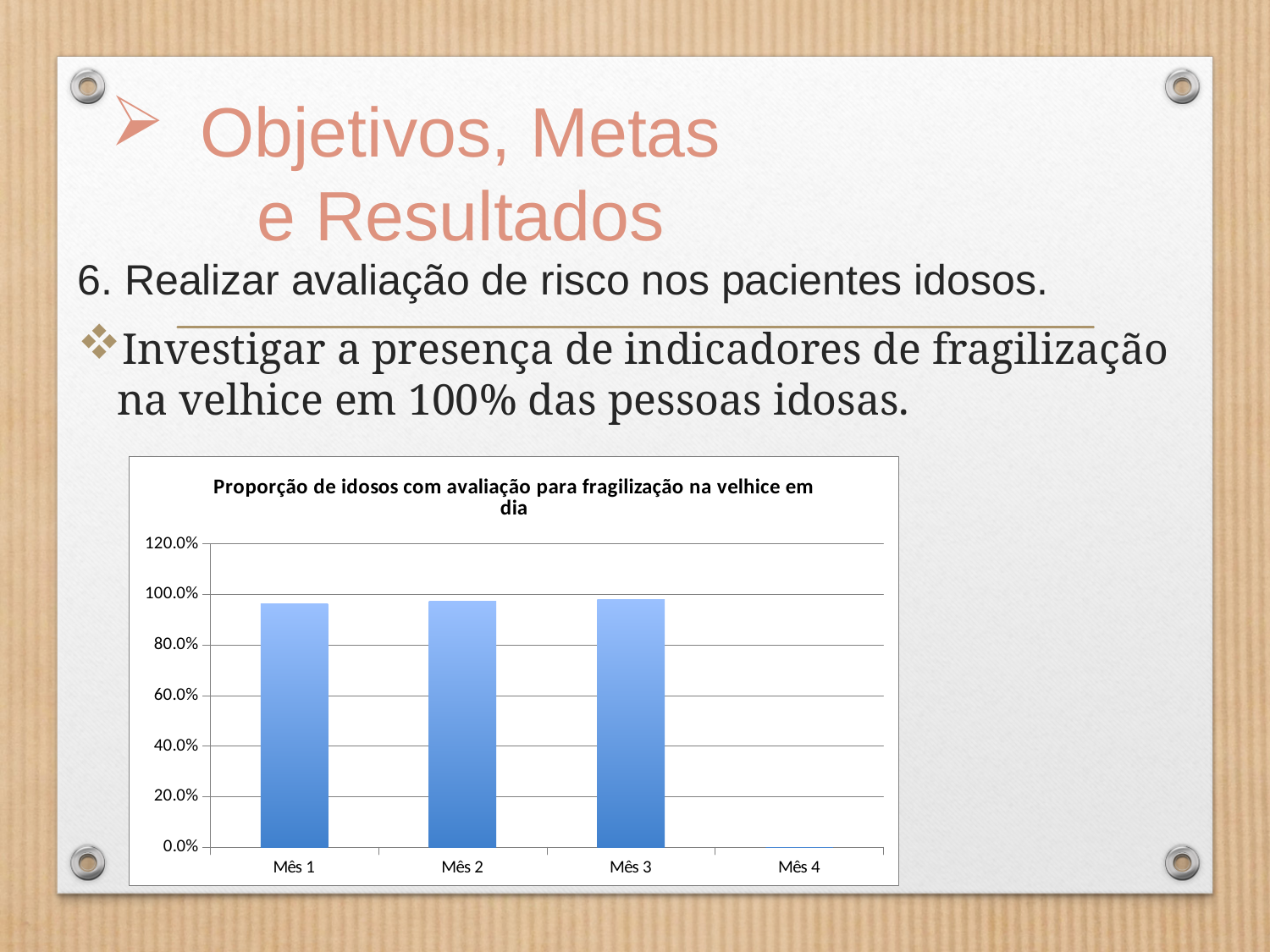
Is the value for Mês 1 greater or less than 80.0%? greater What is the highest value shown on the y axis of the chart? 120.0% Is the value for Mês 3 greater or less than 80.0%? greater How many categories are shown on the x axis of the chart? 4 Is the value for Mês 1 greater or less than 100.0%? less What kind of chart is shown on the slide? bar chart Which is larger, the value for Mês 2 or the value for Mês 4? Mês 2 Which category has the lowest value in the chart? Mês 4 Which category has no visible bar in the chart? Mês 4 What is the title of the chart? Proporção de idosos com avaliação para fragilização na velhice em dia